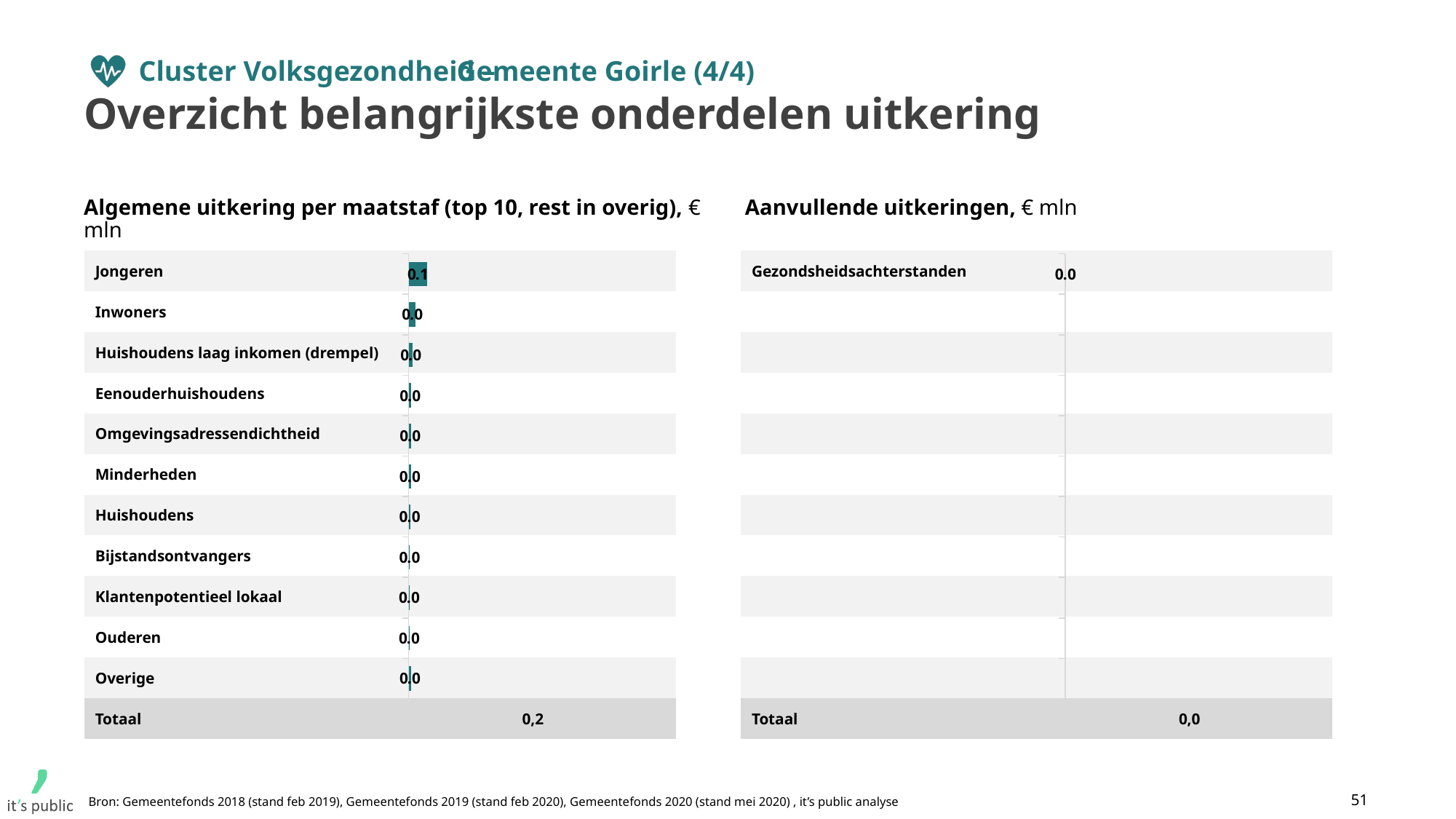
In the chart 'Algemene uitkering per maatstaf', what is the difference between the value for Jongeren and the value for Inwoners? 0.1 In the chart 'Algemene uitkering per maatstaf', how many categories are shown (excluding the Totaal row)? 11 In the chart 'Algemene uitkering per maatstaf', what is the value for Inwoners? 0.0 What kind of chart is the 'Algemene uitkering per maatstaf' chart? bar chart In the chart 'Algemene uitkering per maatstaf', which is larger: the value for Jongeren or the value for Ouderen? Jongeren In the chart 'Aanvullende uitkeringen', how many categories are shown (excluding the Totaal row)? 1 In the chart 'Aanvullende uitkeringen', what is the Totaal value? 0,0 In the chart 'Algemene uitkering per maatstaf', what is the value for Jongeren? 0.1 In the chart 'Aanvullende uitkeringen', what is the value for Gezondsheidsachterstanden? 0.0 In the chart 'Algemene uitkering per maatstaf', what is the Totaal value? 0,2 In the chart 'Algemene uitkering per maatstaf', which category has the highest value? Jongeren What unit is stated in the title of the 'Aanvullende uitkeringen' chart? € mln